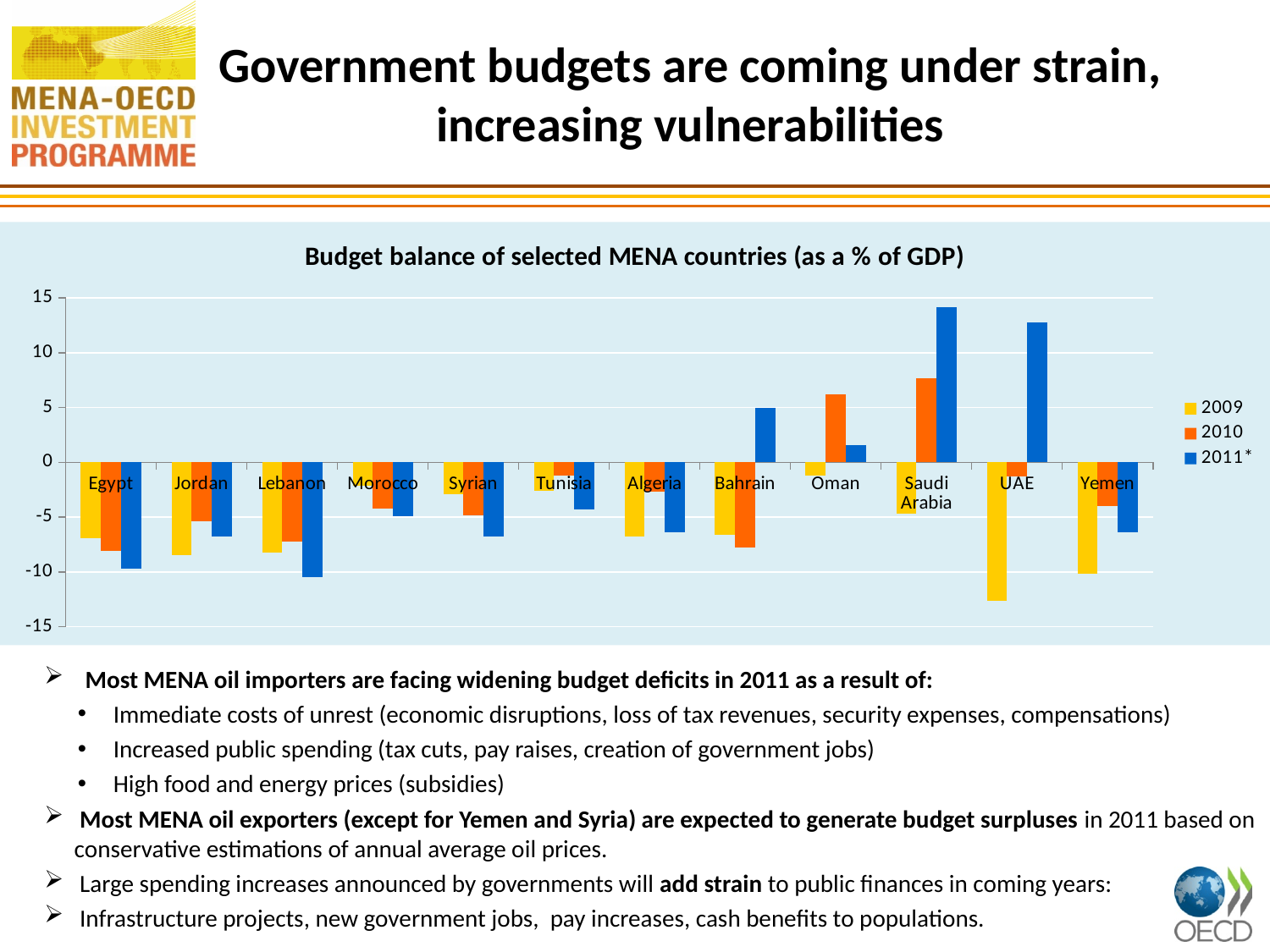
What kind of chart is shown on the slide? bar chart Which is larger, the 2011* value for Saudi Arabia or the 2011* value for UAE? Saudi Arabia Is the 2011* value for Egypt greater or less than -5? less Is the 2010 value for Oman greater or less than 5? greater Which country has the highest 2011* budget balance in the chart? Saudi Arabia How many series does the chart legend list? 3 Is the 2011* value for Saudi Arabia greater or less than 10? greater Which country has the lowest 2009 budget balance in the chart? UAE Which colour represents the 2011* series in the chart? blue What is the title of the chart? Budget balance of selected MENA countries (as a % of GDP) How many countries are shown on the x axis of the chart? 12